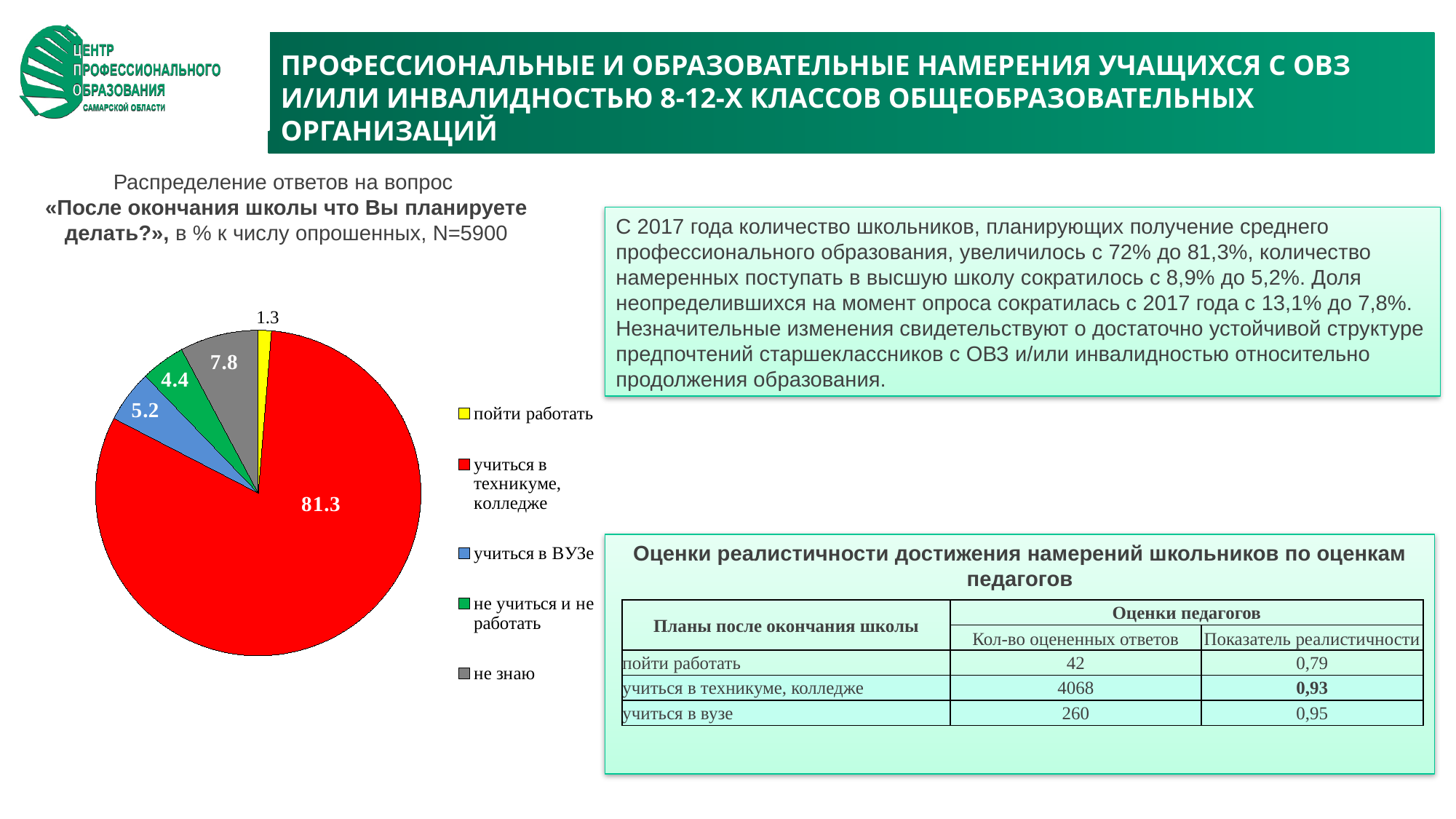
What type of chart is shown on the slide? pie chart Which category has the largest slice in the pie chart? учиться в техникуме, колледже What is the value for "не знаю" in the pie chart? 7.8 What is the difference between the values for "не знаю" and "учиться в ВУЗе"? 2.6 Which category has the smallest slice in the pie chart? пойти работать What is the value for "учиться в ВУЗе" in the pie chart? 5.2 Which is larger: the value for "учиться в ВУЗе" or the value for "не учиться и не работать"? учиться в ВУЗе What colour is the slice for "не знаю" in the pie chart? gray What is the value for "не учиться и не работать" in the pie chart? 4.4 What is the value for "учиться в техникуме, колледже" in the pie chart? 81.3 What is the value for "пойти работать" in the pie chart? 1.3 How many slices does the pie chart have? 5